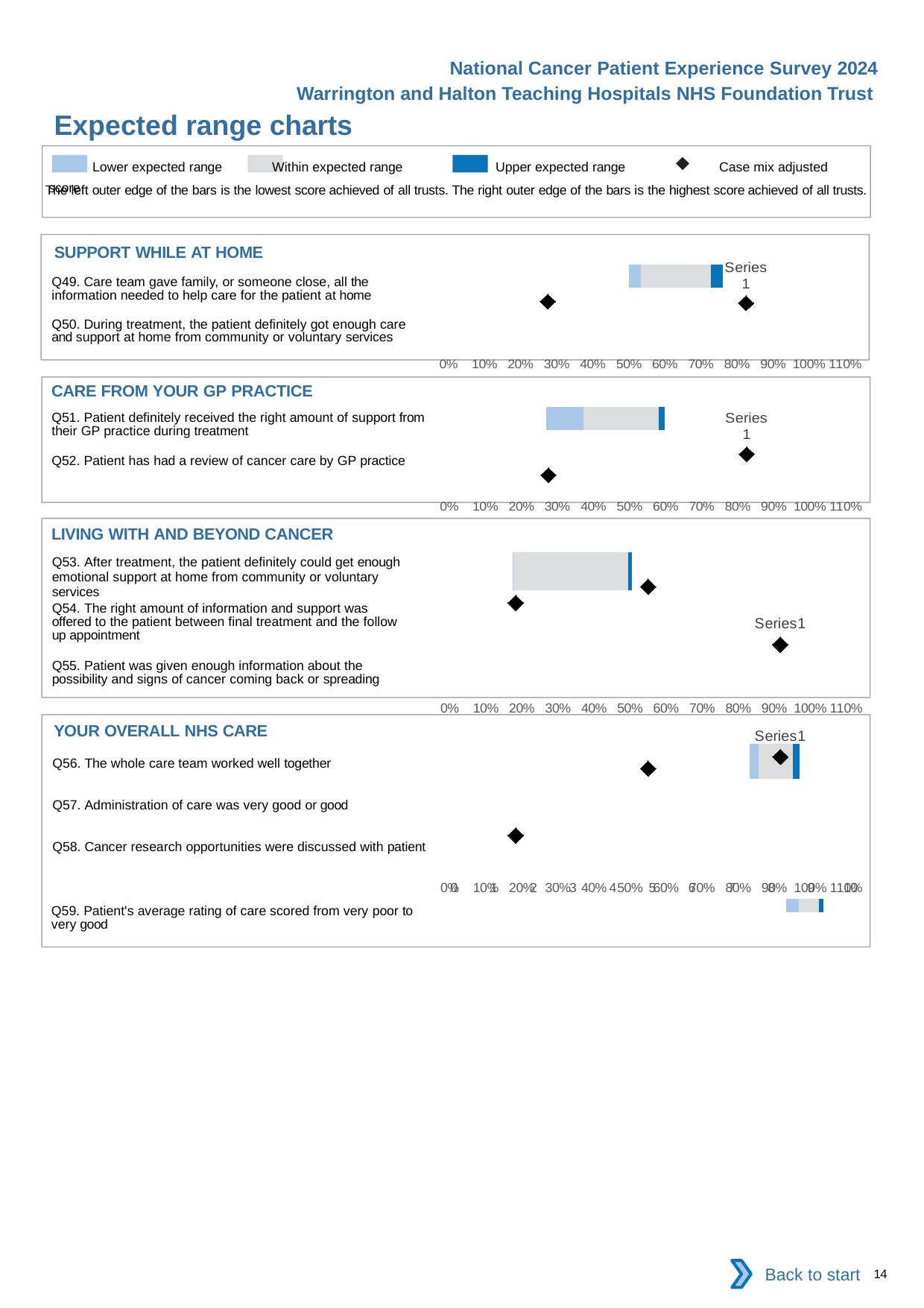
According to the legend, what does the diamond marker represent? Case mix adjusted score How many diamond markers are plotted in the LIVING WITH AND BEYOND CANCER chart? 3 How many questions are listed in the YOUR OVERALL NHS CARE section? 4 In the YOUR OVERALL NHS CARE chart, is the left edge of the upper expected range bar greater or less than 80%? greater What kind of chart is used in the SUPPORT WHILE AT HOME section? bar chart How many entries does the legend at the top of the slide list? 4 In the SUPPORT WHILE AT HOME chart, is the right edge of the expected range bar greater or less than 70%? greater In the CARE FROM YOUR GP PRACTICE chart, is the left edge of the expected range bar greater or less than 20%? greater How many sections of expected range charts are shown on the slide? 4 What is the highest percentage tick shown on the x axis of the CARE FROM YOUR GP PRACTICE chart? 110%